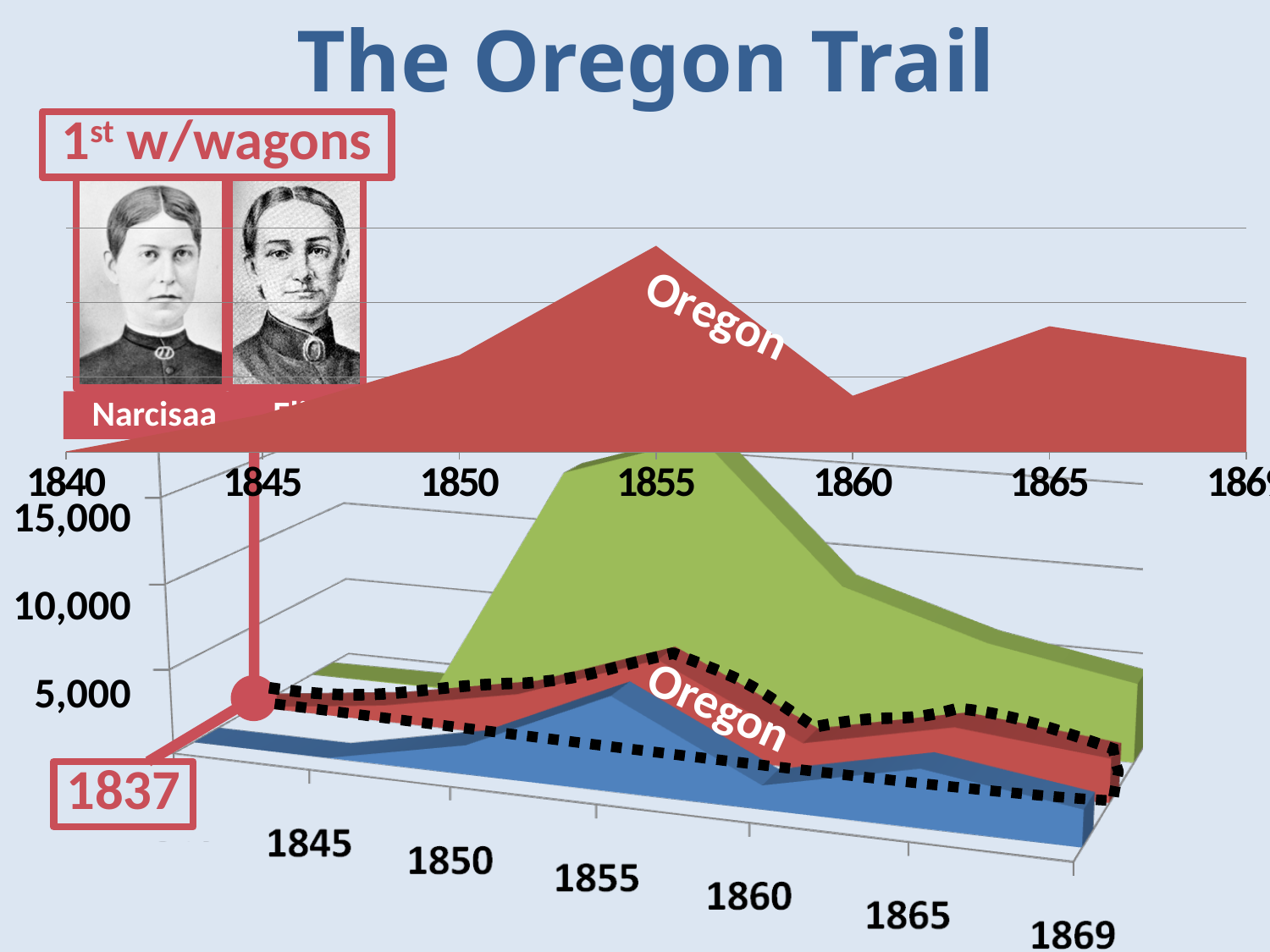
What is the highest value labelled on the vertical axis of the bottom chart? 15,000 In the top chart, in which year does the Oregon area reach its highest point? 1855 In the top chart, which year has the larger Oregon value, 1855 or 1865? 1855 How many coloured stacked areas are plotted in the bottom chart? 3 In the top chart, which year has the larger Oregon value, 1860 or 1865? 1865 In the top chart, does the Oregon value rise or fall between 1860 and 1865? rise What kind of chart is the bottom chart on the slide? area chart In the top chart, does the Oregon value rise or fall between 1840 and 1855? rise What is the last year labelled on the horizontal axis of the bottom chart? 1869 In the top chart, does the Oregon value rise or fall between 1855 and 1860? fall What kind of chart is the top chart on the slide? area chart In the bottom chart, in which year does the green area reach its highest point? 1855